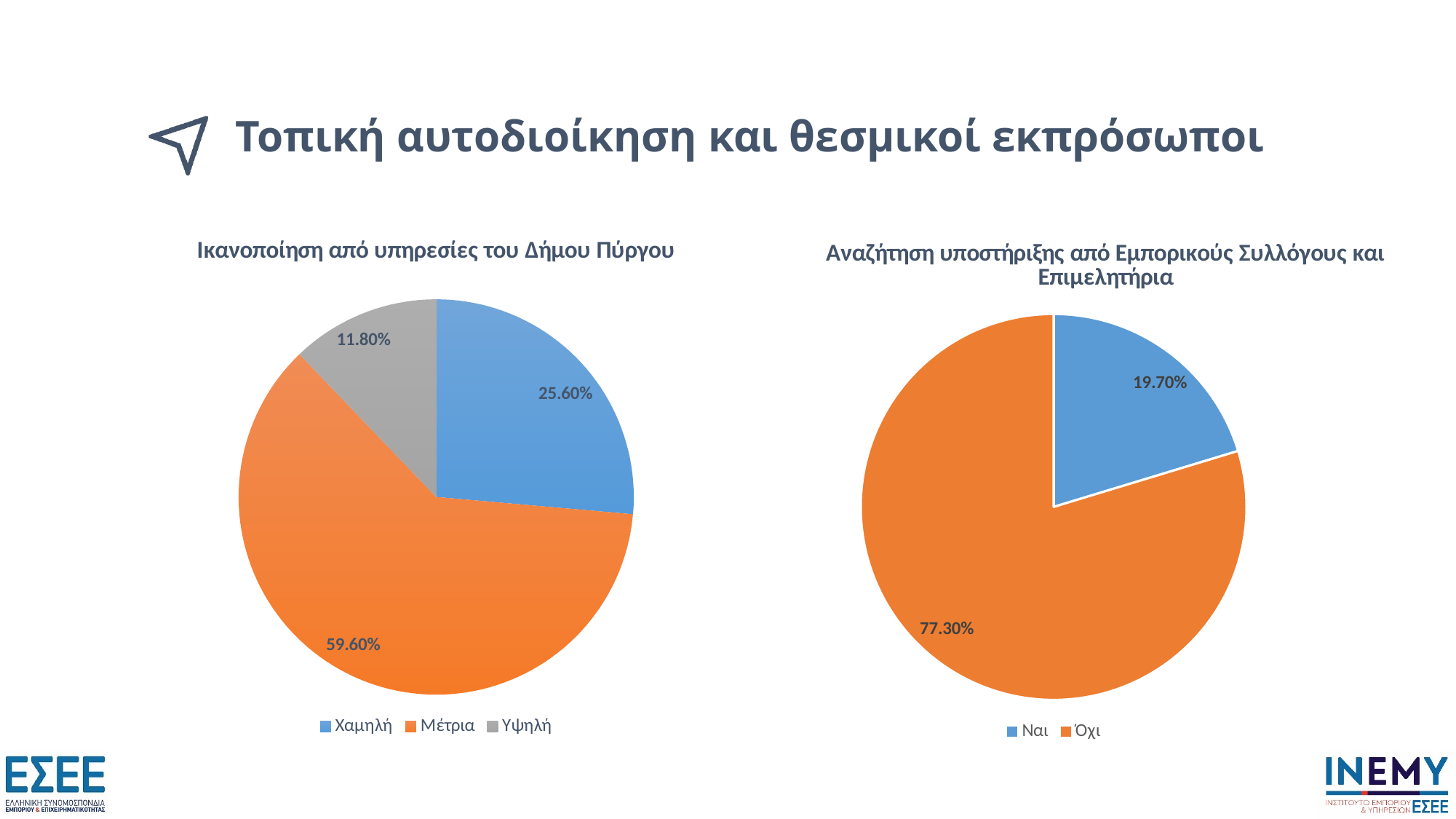
In the right chart 'Αναζήτηση υποστήριξης από Εμπορικούς Συλλόγους και Επιμελητήρια', what is the value for Όχι? 77.30% In the left chart 'Ικανοποίηση από υπηρεσίες του Δήμου Πύργου', what is the value for Υψηλή? 11.80% In the left chart 'Ικανοποίηση από υπηρεσίες του Δήμου Πύργου', what is the difference between Χαμηλή and Υψηλή? 13.80% In the left chart 'Ικανοποίηση από υπηρεσίες του Δήμου Πύργου', which category has the smallest share? Υψηλή In the right chart 'Αναζήτηση υποστήριξης από Εμπορικούς Συλλόγους και Επιμελητήρια', what colour is the Ναι slice? Blue In the left chart 'Ικανοποίηση από υπηρεσίες του Δήμου Πύργου', what is the value for Μέτρια? 59.60% In the left chart 'Ικανοποίηση από υπηρεσίες του Δήμου Πύργου', how many categories are shown? 3 In the left chart 'Ικανοποίηση από υπηρεσίες του Δήμου Πύργου', which category has the largest share? Μέτρια In the left chart 'Ικανοποίηση από υπηρεσίες του Δήμου Πύργου', what is the value for Χαμηλή? 25.60% In the right chart 'Αναζήτηση υποστήριξης από Εμπορικούς Συλλόγους και Επιμελητήρια', which is larger, Ναι or Όχι? Όχι In the right chart 'Αναζήτηση υποστήριξης από Εμπορικούς Συλλόγους και Επιμελητήρια', what is the value for Ναι? 19.70% What kind of chart is the right chart 'Αναζήτηση υποστήριξης από Εμπορικούς Συλλόγους και Επιμελητήρια'? Pie chart